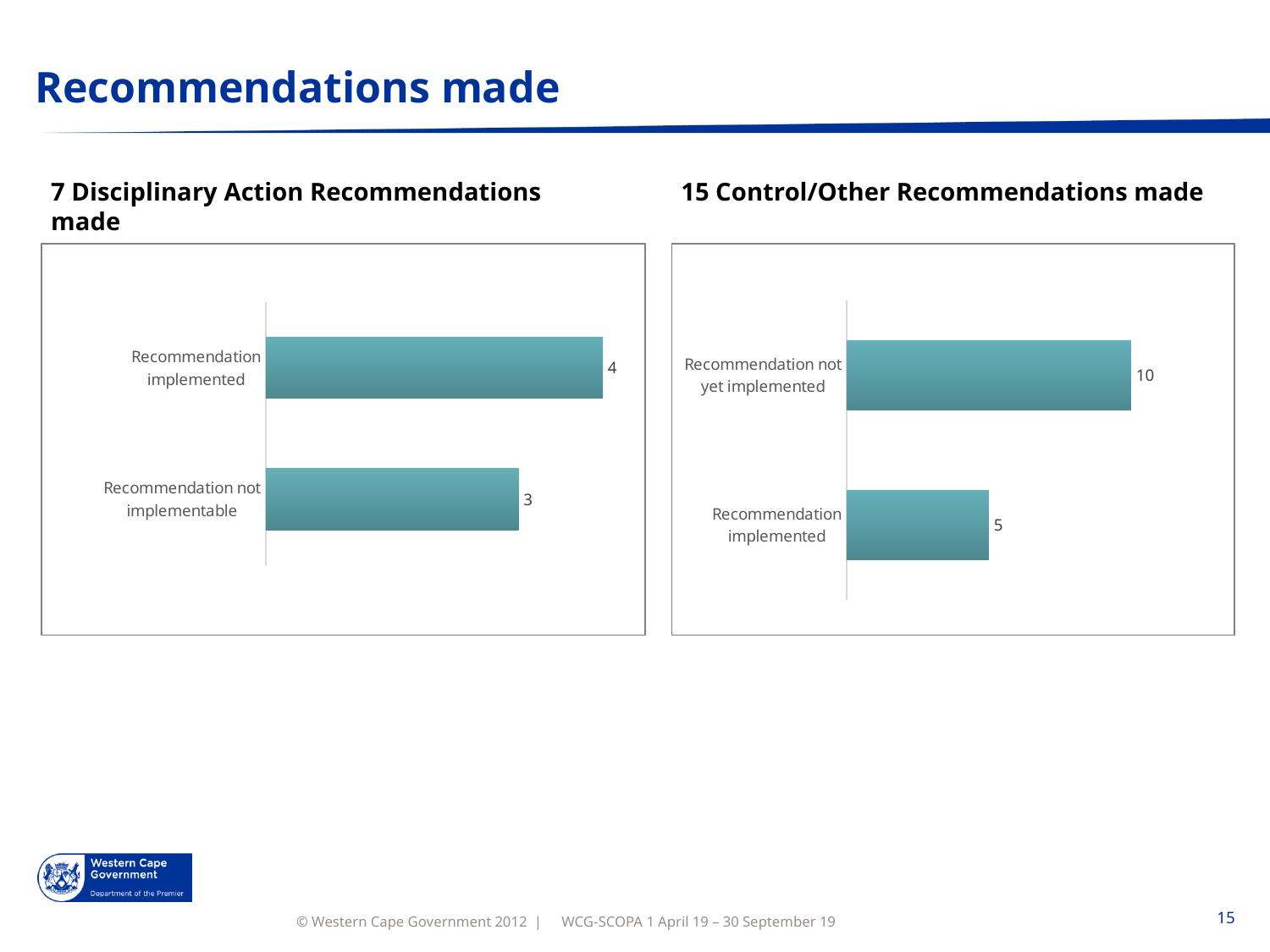
In the '7 Disciplinary Action Recommendations made' chart, which category has the lowest value? Recommendation not implementable In the '7 Disciplinary Action Recommendations made' chart, which is larger: 'Recommendation implemented' or 'Recommendation not implementable'? Recommendation implemented In the '15 Control/Other Recommendations made' chart, what is the difference between 'Recommendation not yet implemented' and 'Recommendation implemented'? 5 What is the title of the chart on the right side of the slide? 15 Control/Other Recommendations made In the '15 Control/Other Recommendations made' chart, what is the value for 'Recommendation implemented'? 5 In the '7 Disciplinary Action Recommendations made' chart, what is the difference between 'Recommendation implemented' and 'Recommendation not implementable'? 1 In the '7 Disciplinary Action Recommendations made' chart, what is the value for 'Recommendation not implementable'? 3 In the '7 Disciplinary Action Recommendations made' chart, what is the value for 'Recommendation implemented'? 4 How many categories are shown in the '15 Control/Other Recommendations made' chart? 2 In the '15 Control/Other Recommendations made' chart, which category has the highest value? Recommendation not yet implemented What type of chart is the '7 Disciplinary Action Recommendations made' chart? Bar chart In the '15 Control/Other Recommendations made' chart, what is the value for 'Recommendation not yet implemented'? 10